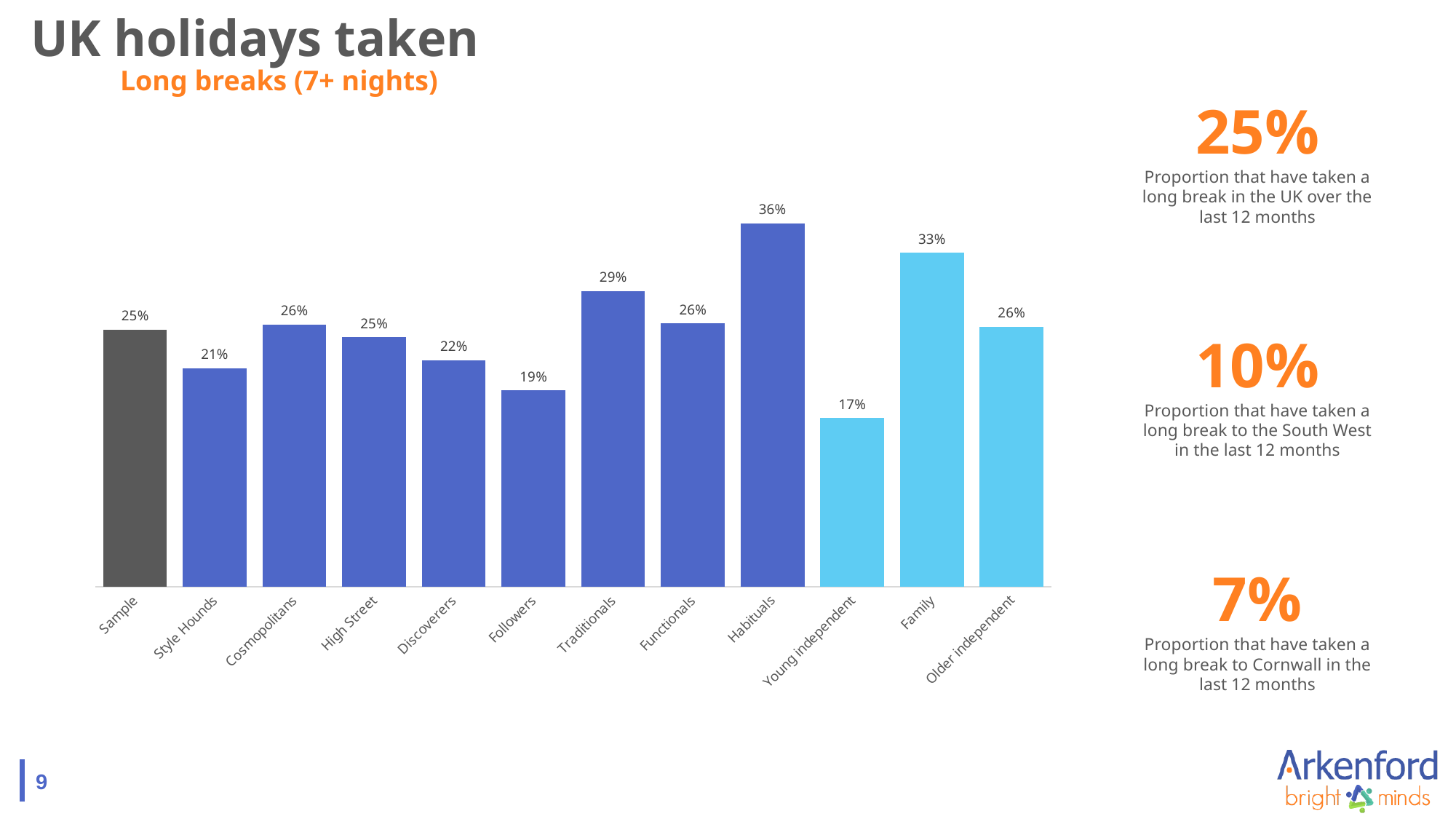
How many categories are shown on the x axis? 12 What is the value for Family? 33% What is the value for Young independent? 17% Which category has the lowest value? Young independent What is the value for Followers? 19% What kind of chart is shown on the slide? Bar chart Which is larger, the value for Traditionals or the value for Discoverers? Traditionals What is the difference between the values for Habituals and Young independent? 19% What is the difference between the values for Family and Sample? 8% Which category has the highest value? Habituals What is the subtitle shown above the chart? Long breaks (7+ nights) What is the value for Habituals? 36%